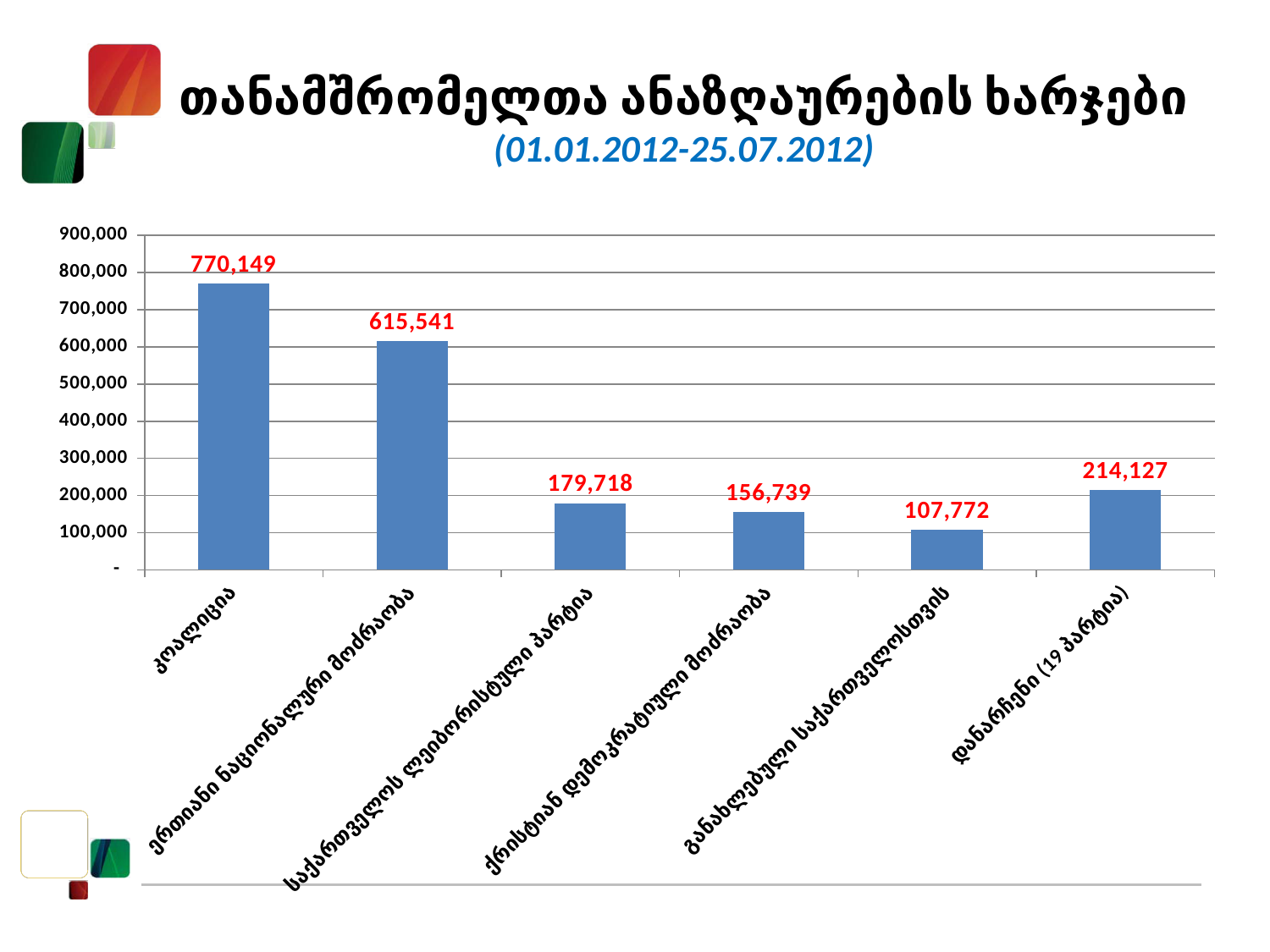
Which category has the lowest value? განახლებული საქართველოსთვის Which category has the highest value? კოალიცია How many categories are shown on the x axis? 6 What date range is given in the chart title? 01.01.2012-25.07.2012 What is the value for დანარჩენი (19 პარტია)? 214,127 What is the value for საქართველოს ლეიბორისტული პარტია? 179,718 What is the difference between the values for კოალიცია and ერთიანი ნაციონალური მოძრაობა? 154,608 What kind of chart is shown on the slide? Bar chart Which is larger: the value for ქრისტიან დემოკრატიული მოძრაობა or the value for დანარჩენი (19 პარტია)? დანარჩენი (19 პარტია) What is the value for ერთიანი ნაციონალური მოძრაობა? 615,541 What is the value for კოალიცია? 770,149